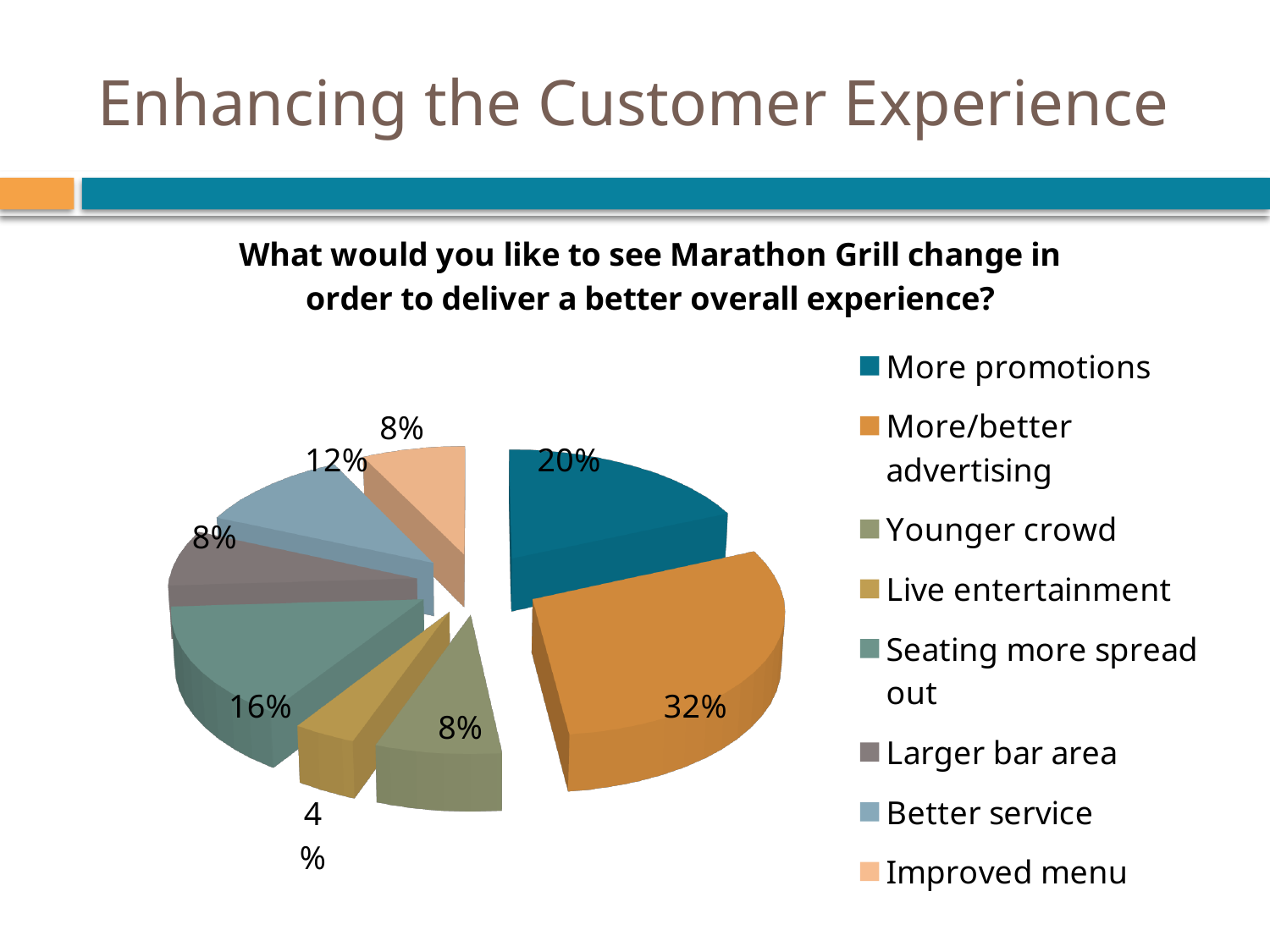
How many categories does the legend list? 8 What kind of chart is shown on the slide? pie chart Which category has the smallest share of the pie? Live entertainment Which is larger, the share for Seating more spread out or the share for Better service? Seating more spread out What percentage of respondents chose Seating more spread out? 16% What percentage of respondents chose More promotions? 20% Which category has the largest share of the pie? More/better advertising What is the difference in percentage points between More/better advertising and More promotions? 12 What percentage of respondents chose More/better advertising? 32% What is the chart's title? What would you like to see Marathon Grill change in order to deliver a better overall experience? What percentage of respondents chose Live entertainment? 4% What percentage of respondents chose Better service? 12%